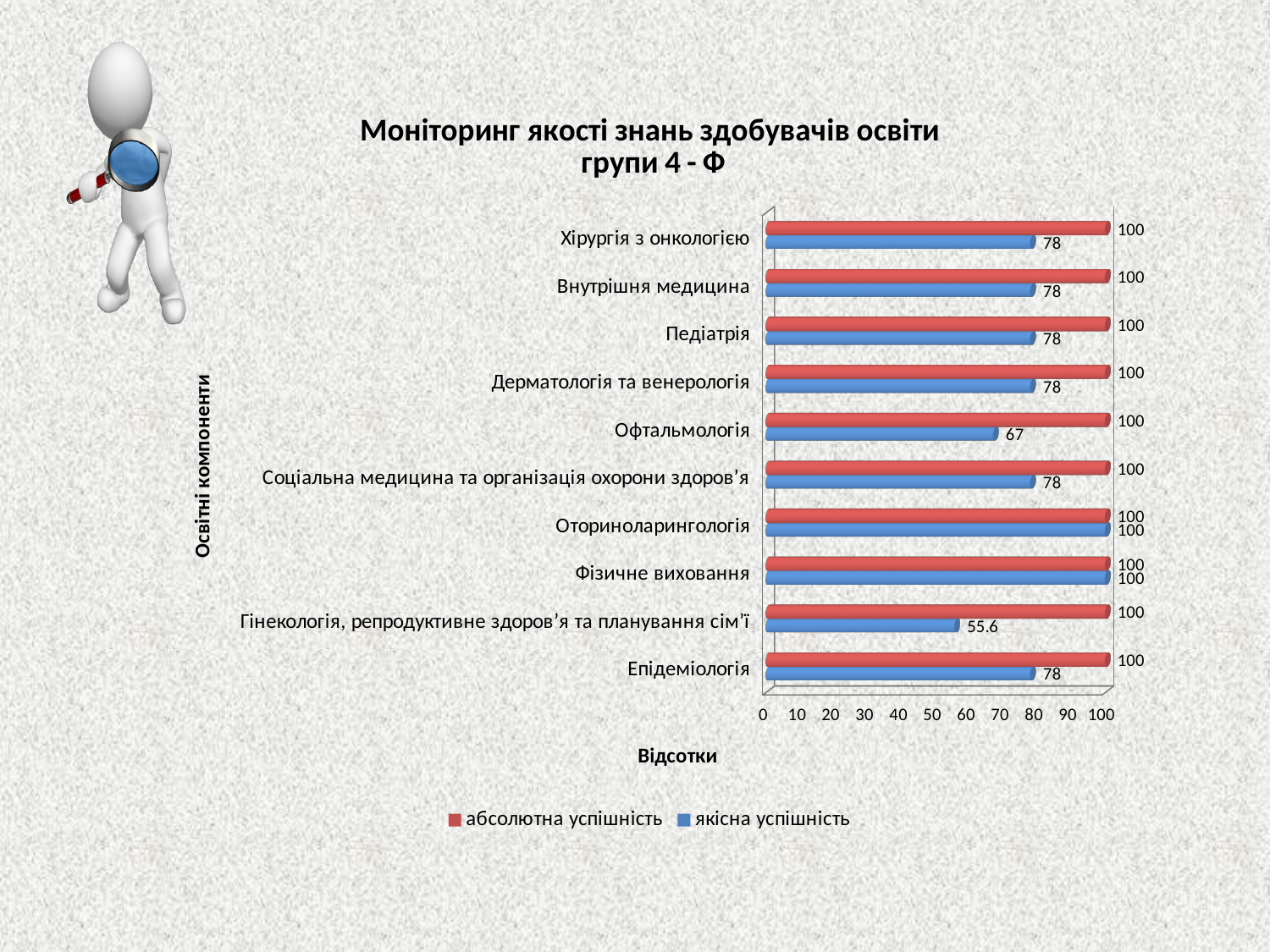
What is the value of якісна успішність for Офтальмологія? 67 Which is larger: якісна успішність for Хірургія з онкологією or for Офтальмологія? Хірургія з онкологією What is the value of якісна успішність for Гінекологія, репродуктивне здоров’я та планування сім’ї? 55.6 What is the value of якісна успішність for Епідеміологія? 78 Which category has the lowest якісна успішність? Гінекологія, репродуктивне здоров’я та планування сім’ї What is the title of the chart? Моніторинг якості знань здобувачів освіти групи 4 - Ф How many series does the legend list? 2 What is the difference between абсолютна успішність and якісна успішність for Офтальмологія? 33 What kind of chart is shown on the slide? bar chart How many categories are shown on the chart? 10 What is the value of абсолютна успішність for Педіатрія? 100 What is the label of the horizontal axis? Відсотки